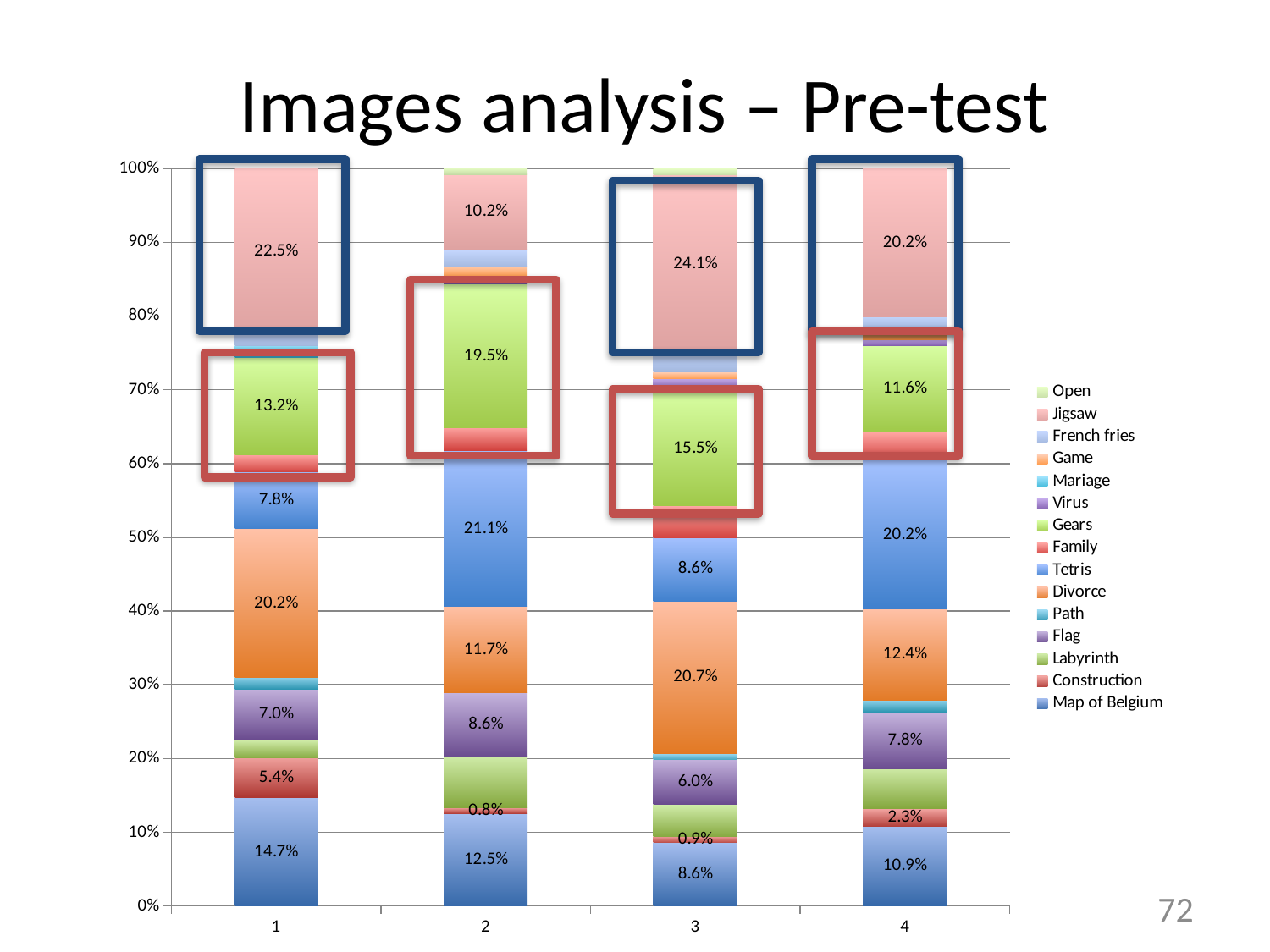
What is the difference between the Tetris values for category 2 and category 1? 13.3 percentage points Which category has the highest Jigsaw value? 3 Which category has the lowest Construction value? 2 Which category has the larger Divorce value, 1 or 4? 1 What is the value of the Divorce segment for category 4? 12.4% What is the value of the Jigsaw segment for category 3? 24.1% What is the value of the Map of Belgium segment for category 1? 14.7% How many categories are shown on the x axis? 4 What is the value of the Gears segment for category 2? 19.5% What is the title of the slide? Images analysis – Pre-test What kind of chart is shown on the slide? Stacked bar chart How many series does the legend list? 15